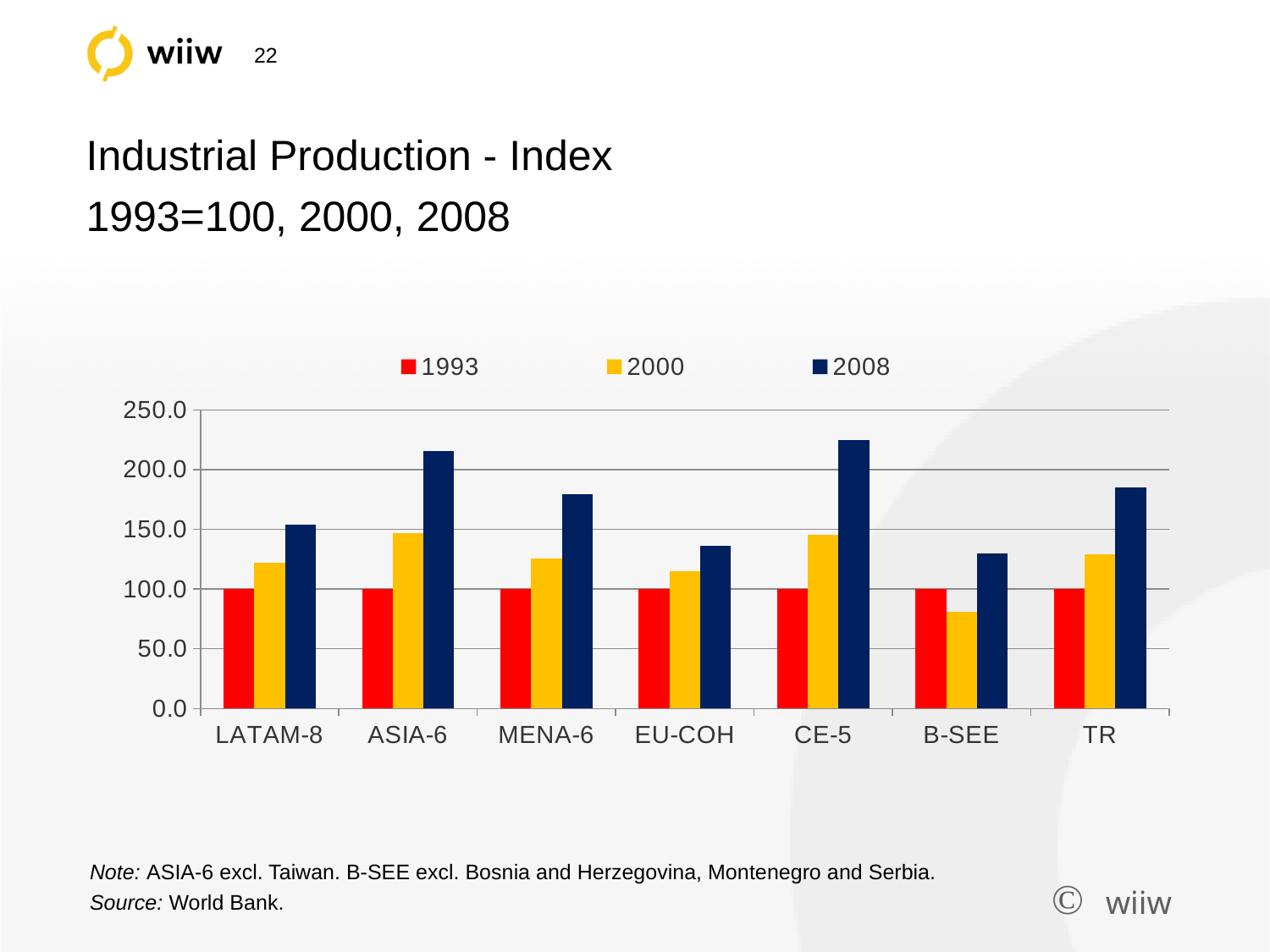
Which category has the lowest 2000 value? B-SEE Is the 2000 value for B-SEE greater or less than 100? less What kind of chart is shown on the slide? bar chart Which category has the highest 2008 value? CE-5 What is the value of the 1993 bar for LATAM-8? 100.0 Which is larger: the 2008 value for CE-5 or the 2008 value for EU-COH? CE-5 How many series does the legend list? 3 Is the 2008 value for EU-COH greater or less than 150? less Is the 2008 value for ASIA-6 greater or less than 200? greater How many regional categories are shown on the x axis? 7 For B-SEE, does the value fall or rise from 1993 to 2000? fall What source is cited for the chart data? World Bank